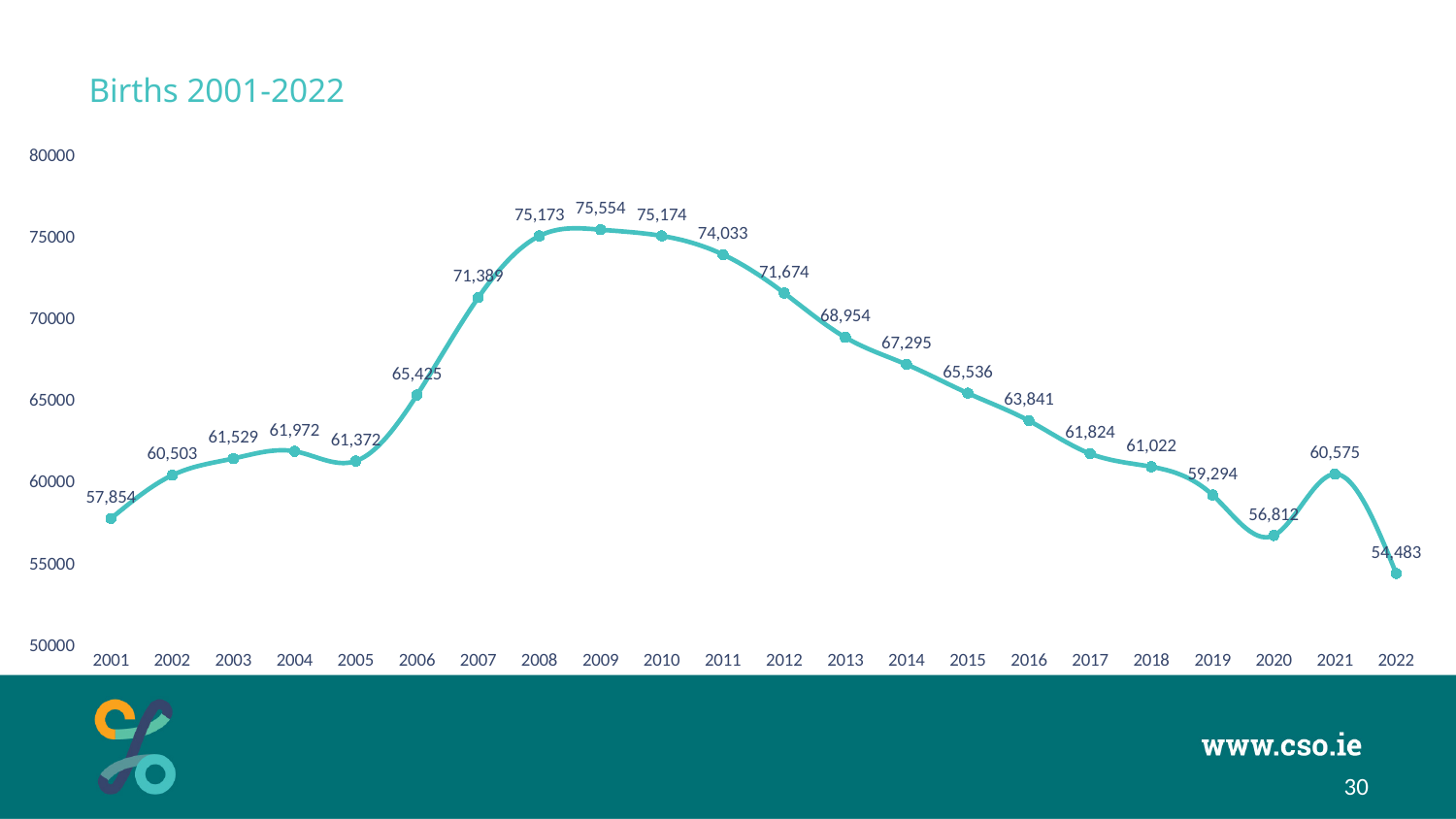
Which year has the highest number of births? 2009 How many years are plotted on the chart? 22 What is the number of births shown for 2020? 56,812 What kind of chart is shown on the slide? Line chart What is the difference between the births in 2021 and the births in 2020? 3,763 Which year had more births, 2007 or 2012? 2012 What is the number of births shown for 2022? 54,483 Which year has the lowest number of births? 2022 What is the number of births shown for 2001? 57,854 What is the difference between the births in 2009 and the births in 2022? 21,071 What is the number of births shown for 2009? 75,554 Do the births rise or fall from 2009 to 2020? Fall